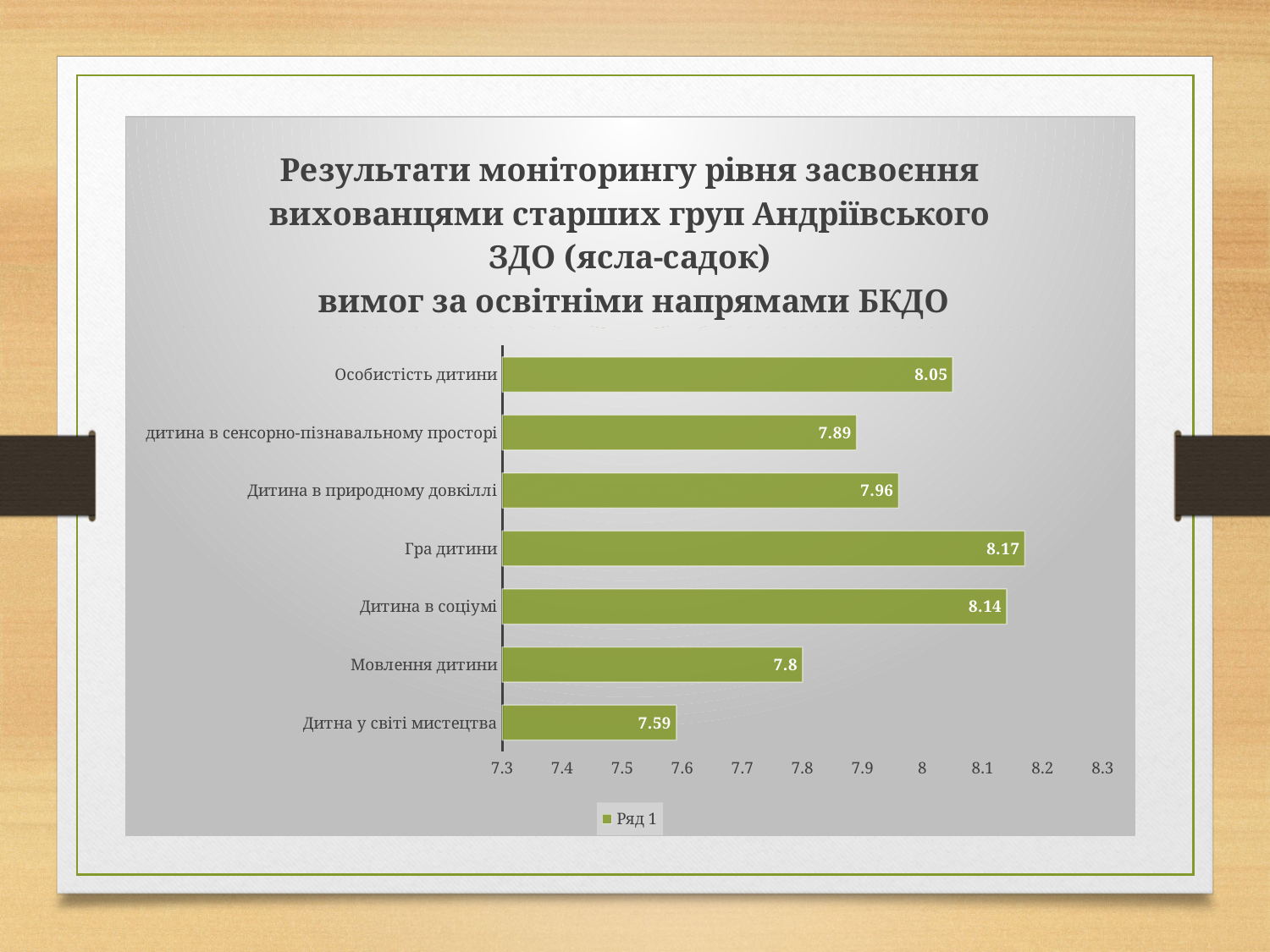
What is the value for Гра дитини? 8.17 How many categories are shown in the chart? 7 How many series does the legend list? 1 What is the legend entry shown below the chart? Ряд 1 What is the value for Мовлення дитини? 7.8 Which category has the highest value? Гра дитини What kind of chart is shown on the slide? bar chart Is the value for Дитина в природному довкіллі greater or less than 8? less What is the value for Особистість дитини? 8.05 Which is larger, the value for Дитина в соціумі or the value for Особистість дитини? Дитина в соціумі Which category has the lowest value? Дитна у світі мистецтва What is the difference between the values for Гра дитини and Дитна у світі мистецтва? 0.58